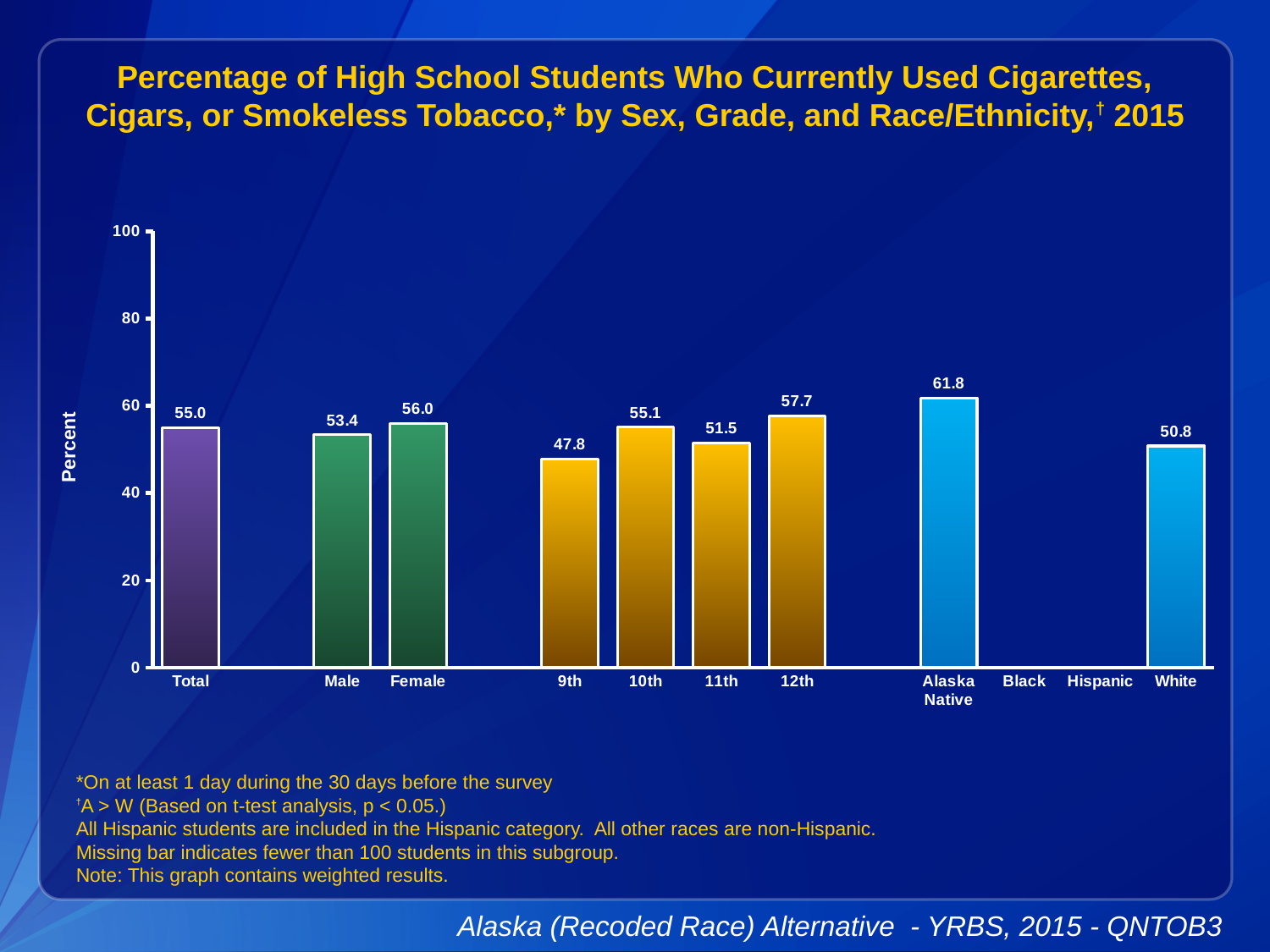
What is the value for 9th grade? 47.8 Which is larger, the value for 10th grade or 11th grade? 10th What is the value for Total? 55.0 Which category has the highest value? Alaska Native What is the difference between the values for 12th and 9th grade? 9.9 Which race/ethnicity categories have no bar shown? Black and Hispanic What is the difference between the values for Male and Female? 2.6 Which category has the lowest value among those with a bar? 9th What is the value for Alaska Native? 61.8 What kind of chart is shown? bar chart Is the value for White greater or less than 60? less What is the value for Female? 56.0